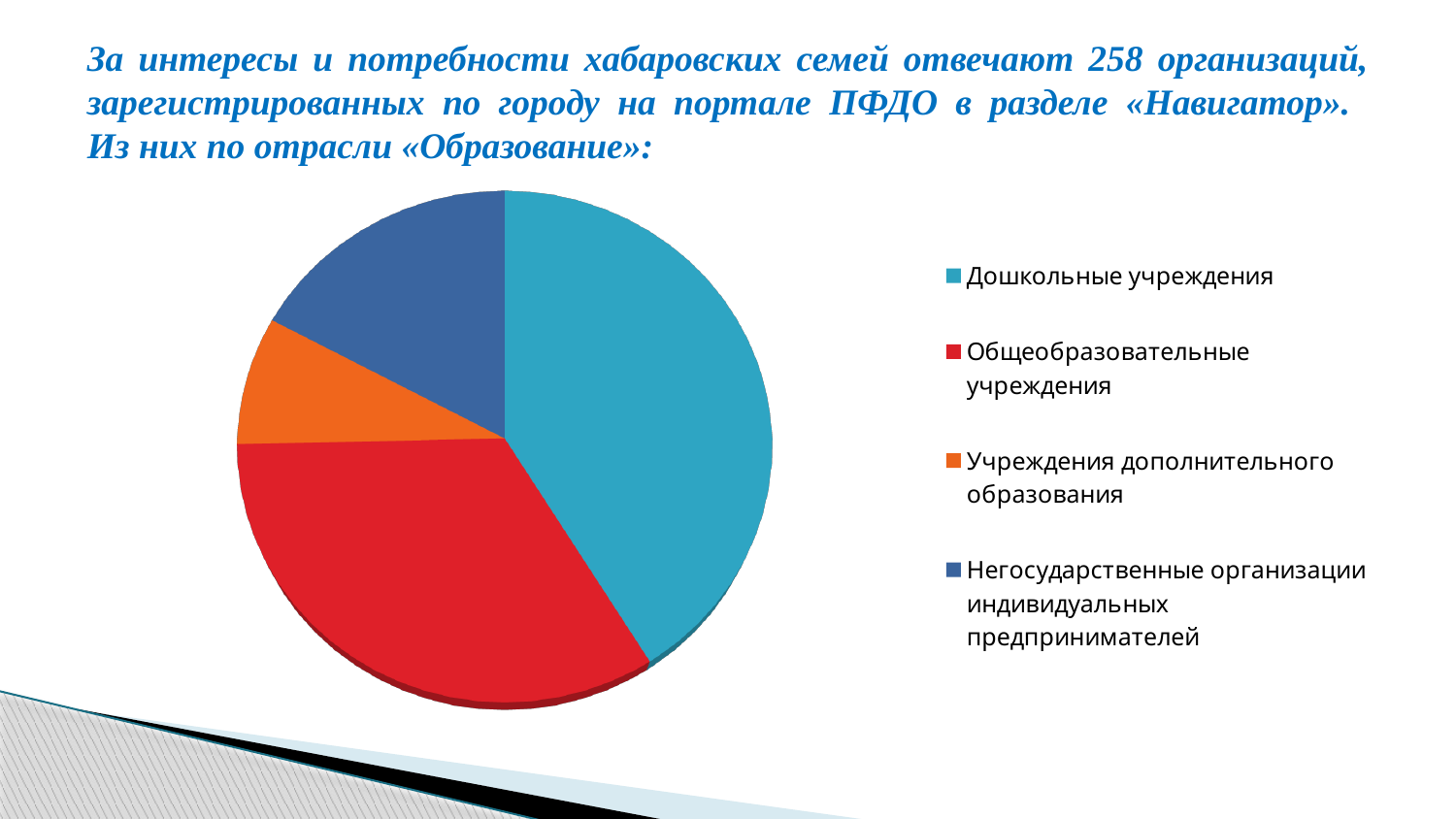
What kind of chart is shown on the slide? pie chart Which slice is larger: Учреждения дополнительного образования or Негосударственные организации индивидуальных предпринимателей? Негосударственные организации индивидуальных предпринимателей Which category is shown in orange in the pie chart? Учреждения дополнительного образования Which slice is larger: Общеобразовательные учреждения or Негосударственные организации индивидуальных предпринимателей? Общеобразовательные учреждения What colour is the slice for Общеобразовательные учреждения? red Which slice is larger: Дошкольные учреждения or Общеобразовательные учреждения? Дошкольные учреждения How many slices does the pie chart have? 4 Which category has the smallest slice of the pie chart? Учреждения дополнительного образования Which category has the largest slice of the pie chart? Дошкольные учреждения